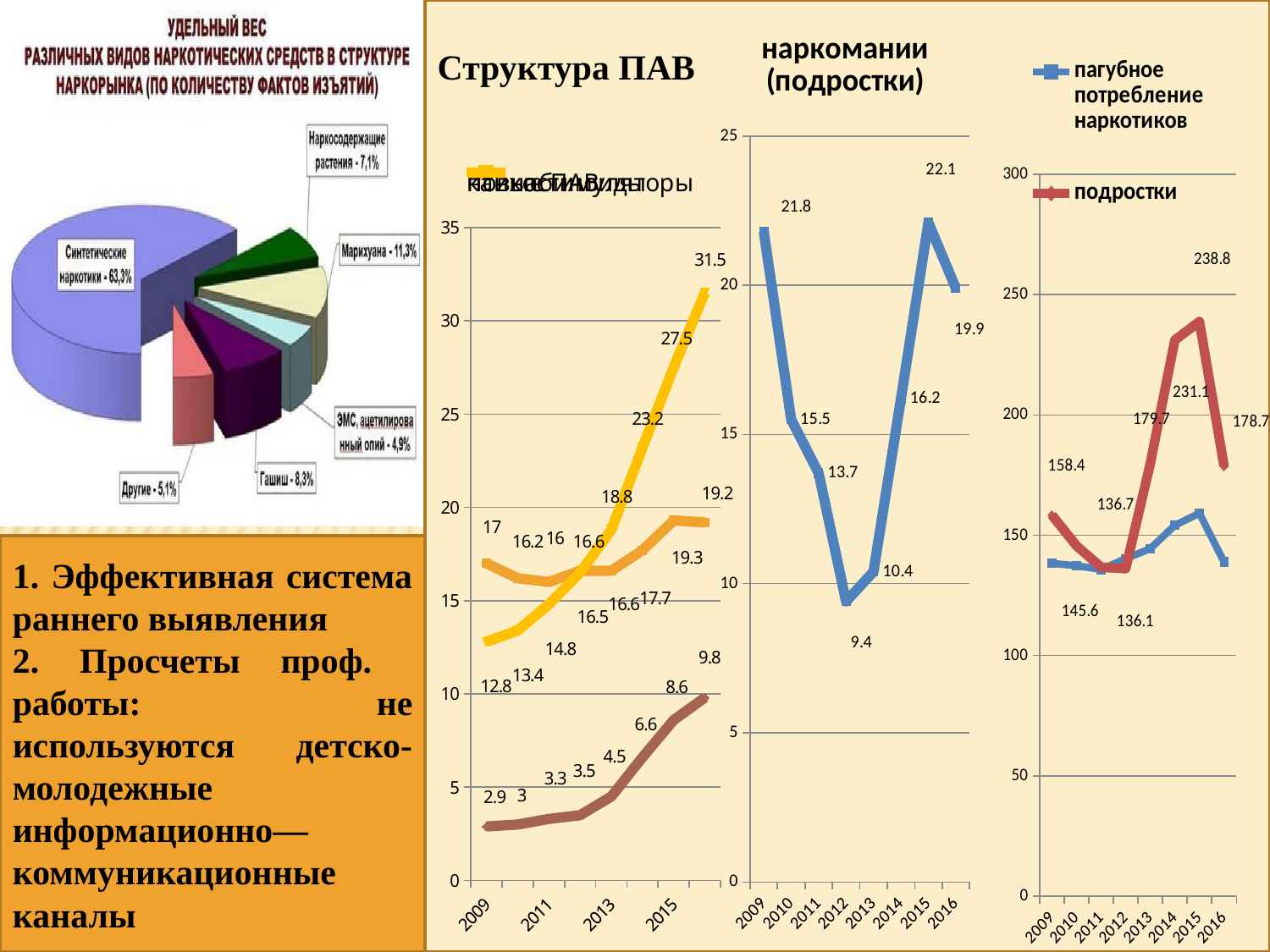
In the pie chart at the top left, how many slices are there? 6 In the chart titled 'наркомании (подростки)', how many years are plotted on the x axis? 8 In the rightmost chart, is the value for 'пагубное потребление наркотиков' in 2015 greater or less than 150? greater In the rightmost chart, what is the highest value shown for the 'подростки' series? 238.8 In the pie chart at the top left, what share is shown for Марихуана? 11,3% What kind of chart is the chart titled 'Структура ПАВ'? line chart In the pie chart at the top left, which is larger: the share for Гашиш or the share for Наркосодержащие растения? Гашиш In the pie chart at the top left, which category has the smallest share? ЭМС, ацетилированный опий In the chart titled 'наркомании (подростки)', what is the value for 2012? 9.4 In the chart titled 'наркомании (подростки)', which year has the highest value? 2015 In the chart titled 'наркомании (подростки)', what is the difference between the 2009 value and the 2012 value? 12.4 In the pie chart at the top left, which category has the largest share? Синтетические наркотики